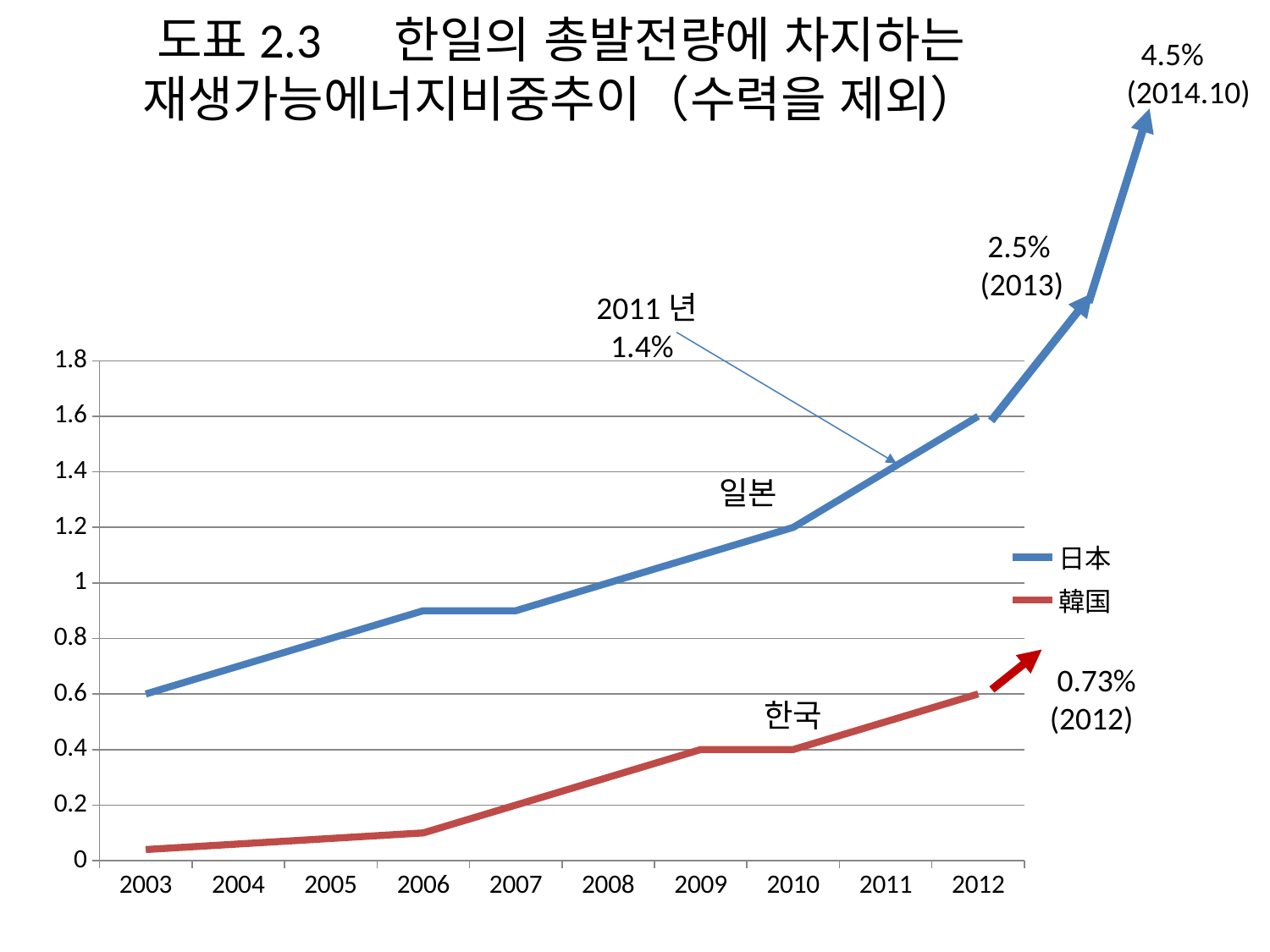
Which series has the larger value in 2012, 日本 or 韓国? 日本 What is the difference between the 日本 and 韓国 values in 2012? 1.0 What is the value for 日本 in 2012? 1.6 What is the value for 日本 in 2003? 0.6 Is the value for 韓国 in 2006 greater or less than 0.2? less What is the value for 日本 in 2010? 1.2 What kind of chart is shown on the slide? line chart What is the value for 韓国 in 2012? 0.6 How many series does the legend list? 2 How many years are shown on the x axis? 10 Do the values for 日本 rise or fall from 2003 to 2012? rise What is the value for 韓国 in 2009? 0.4